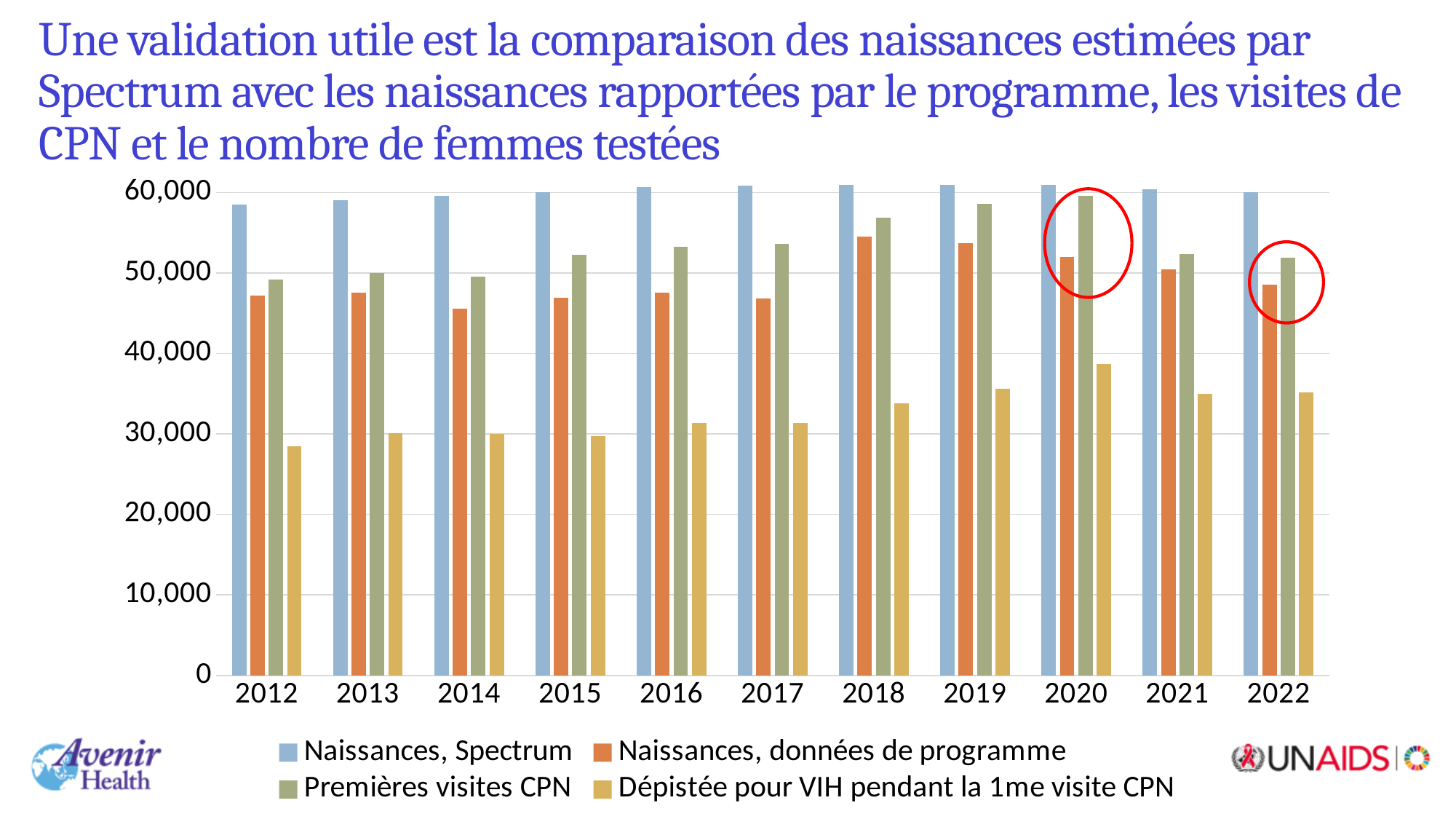
Is the value for 'Premières visites CPN' in 2019 greater or less than 50,000? greater Which two years on the chart are marked with red circles? 2020 and 2022 What kind of chart is shown on the slide? Bar chart In which year is 'Dépistée pour VIH pendant la 1me visite CPN' highest? 2020 Is the value for 'Dépistée pour VIH pendant la 1me visite CPN' in 2012 greater or less than 30,000? less How many years are shown on the x axis? 11 Is the value for 'Naissances, données de programme' in 2014 greater or less than 50,000? less Does 'Dépistée pour VIH pendant la 1me visite CPN' rise or fall from 2012 to 2020? Rise In 2020, which is larger: 'Premières visites CPN' or 'Naissances, données de programme'? Premières visites CPN How many series does the legend list? 4